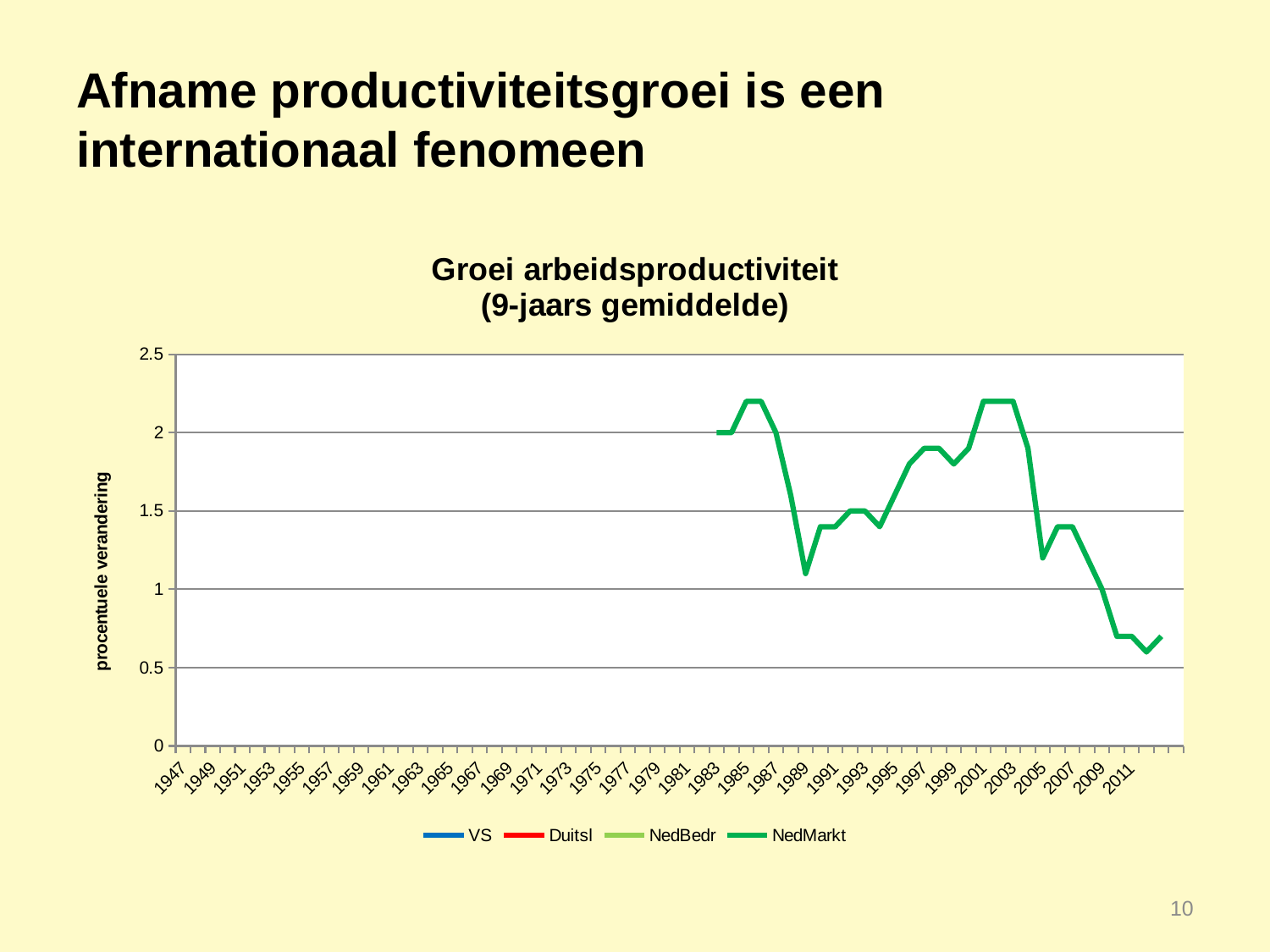
Is the NedMarkt value for 2011 greater or less than 1? less Is the NedMarkt value for 1997 greater or less than 1.5? greater How many series does the chart legend list? 4 Is the NedMarkt value for 2003 greater or less than 2? greater Which series from the legend is actually plotted as a line on the chart? NedMarkt What kind of chart is shown on the slide? line chart Does the NedMarkt line rise or fall between 2003 and 2011? fall Which year has the larger NedMarkt value, 2005 or 2011? 2005 What is the title of the chart? Groei arbeidsproductiviteit (9-jaars gemiddelde) Which year has the larger NedMarkt value, 1985 or 1989? 1985